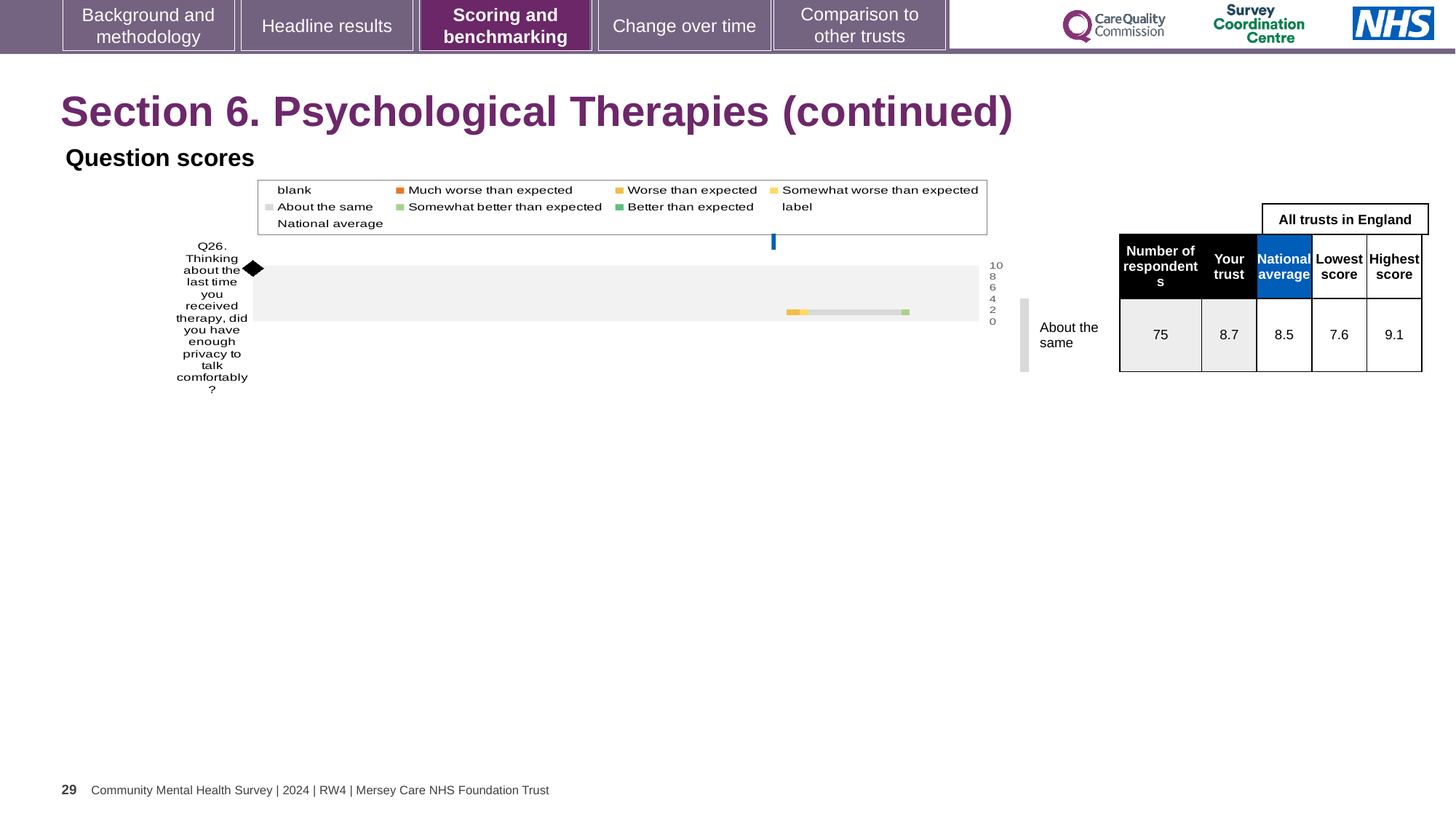
How many respondents answered Q26? 75 What kind of chart is used to show the Q26 question score? bar chart By how much does the 'Your trust' score exceed the national average for Q26? 0.2 What is the highest score among all trusts in England for Q26? 9.1 How many questions are plotted in the Question scores chart? 1 What is the difference between the highest score and the lowest score for Q26? 1.5 Which is higher for Q26, the 'Your trust' score or the national average? Your trust What is the 'Your trust' score for Q26 about having enough privacy to talk comfortably? 8.7 What is the lowest score among all trusts in England for Q26? 7.6 What does the blue marker in the chart represent, according to the legend? National average What is the national average score for Q26? 8.5 What benchmark category is shown next to the Q26 bar? About the same